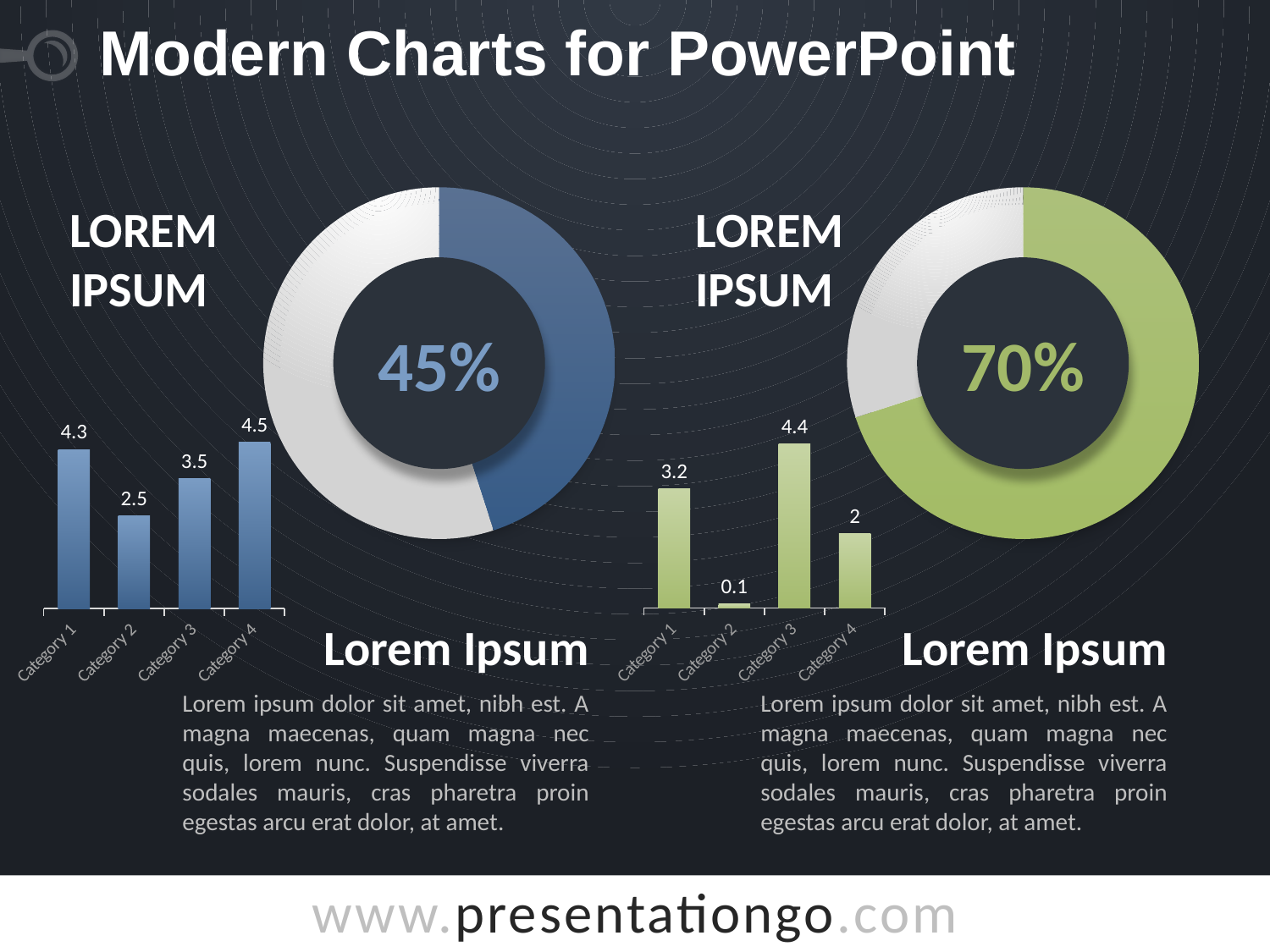
What colour are the bars in the bar chart on the right? Green In the green bar chart on the right, which is larger, Category 1 or Category 4? Category 1 What kind of chart is the chart showing 45% on the left? Donut chart In the green bar chart on the right, what is the value for Category 3? 4.4 How many categories does the blue bar chart on the left show? 4 In the blue bar chart on the left, what is the value for Category 1? 4.3 What percentage is shown in the centre of the green donut chart on the right? 70% In the blue bar chart on the left, which category has the highest value? Category 4 In the green bar chart on the right, what is the difference between Category 3 and Category 2? 4.3 What percentage is shown in the centre of the blue donut chart on the left? 45% In the green bar chart on the right, which category has the lowest value? Category 2 In the blue bar chart on the left, what is the difference between Category 4 and Category 2? 2